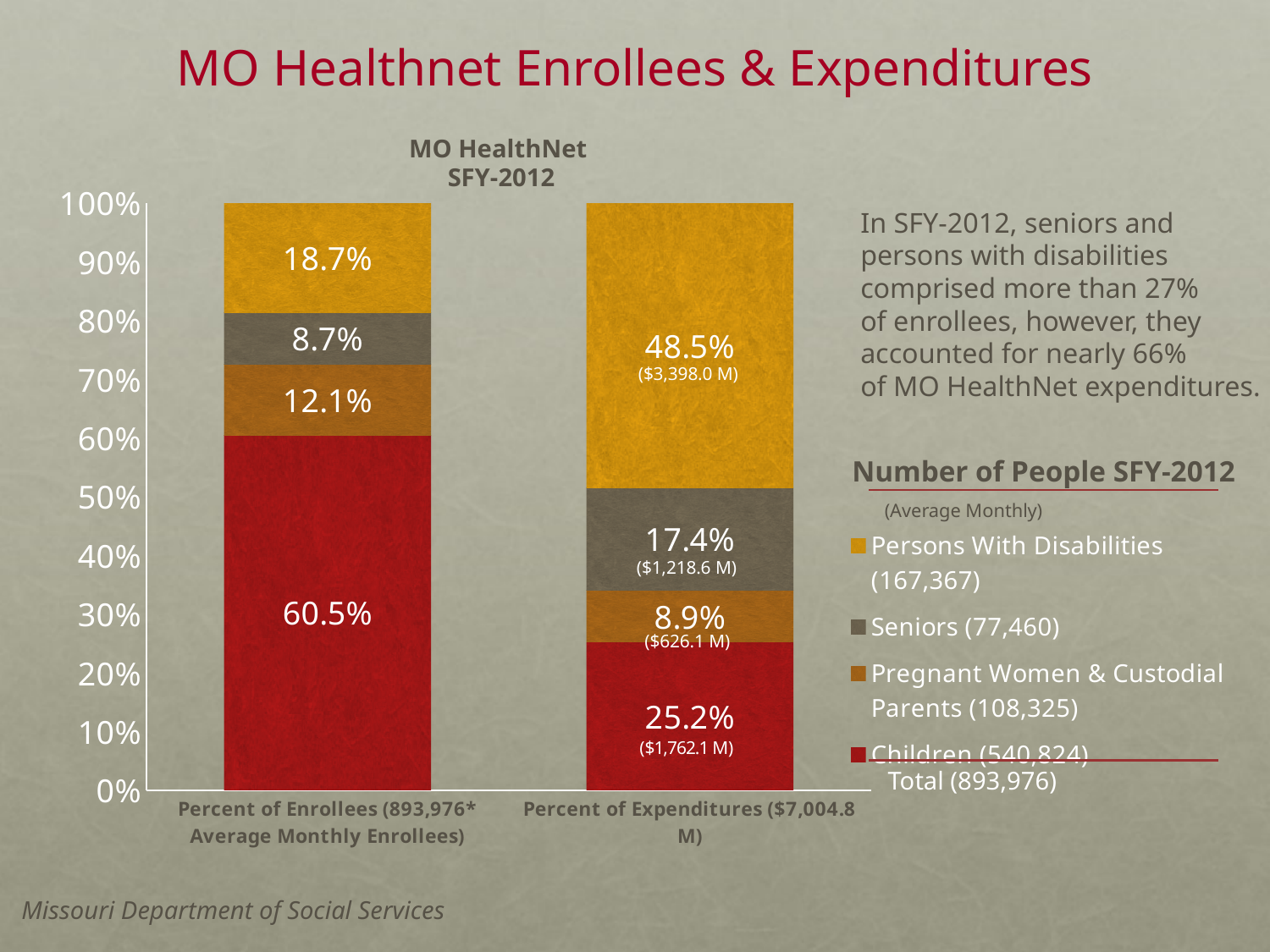
How many series does the legend list? 4 What percentage of enrollees are Children? 60.5% How many bars are plotted in the chart? 2 What percentage of expenditures is attributed to Persons With Disabilities? 48.5% Which group has the smallest share of the Percent of Enrollees bar? Seniors Which is larger: the Seniors share of enrollees or the Seniors share of expenditures? Seniors share of expenditures What is the title of the chart? MO HealthNet SFY-2012 What is the difference between the Children share of enrollees and the Children share of expenditures? 35.3% What is the dollar amount of expenditures for Seniors? $1,218.6 M What kind of chart is shown on the slide? Stacked bar chart Which group has the largest share of the Percent of Expenditures bar? Persons With Disabilities What percentage of enrollees are Seniors? 8.7%